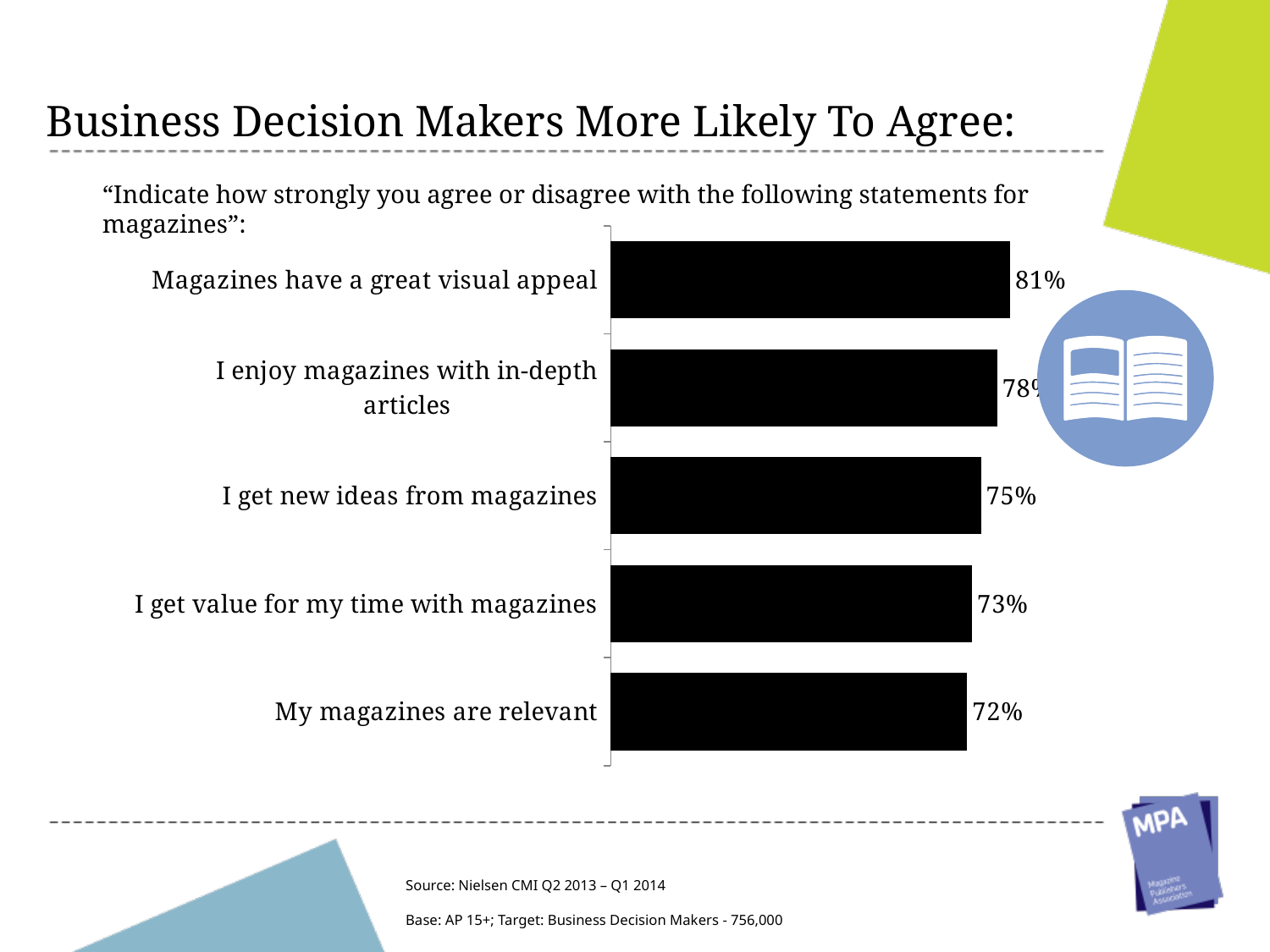
What percentage agree with "I get value for my time with magazines"? 73% What is the value for "My magazines are relevant"? 72% What type of chart is shown on the slide? Bar chart What is the title of the slide containing the chart? Business Decision Makers More Likely To Agree: Which statement has the highest level of agreement? Magazines have a great visual appeal What is the difference between the values for "Magazines have a great visual appeal" and "My magazines are relevant"? 9% What is the value shown for "I get new ideas from magazines"? 75% What percentage of business decision makers agree that magazines have a great visual appeal? 81% Which is larger: the value for "I enjoy magazines with in-depth articles" or for "I get new ideas from magazines"? I enjoy magazines with in-depth articles Which statement has the lowest level of agreement? My magazines are relevant What is the difference between "I get new ideas from magazines" and "I get value for my time with magazines"? 2% How many statements are shown in the chart? 5